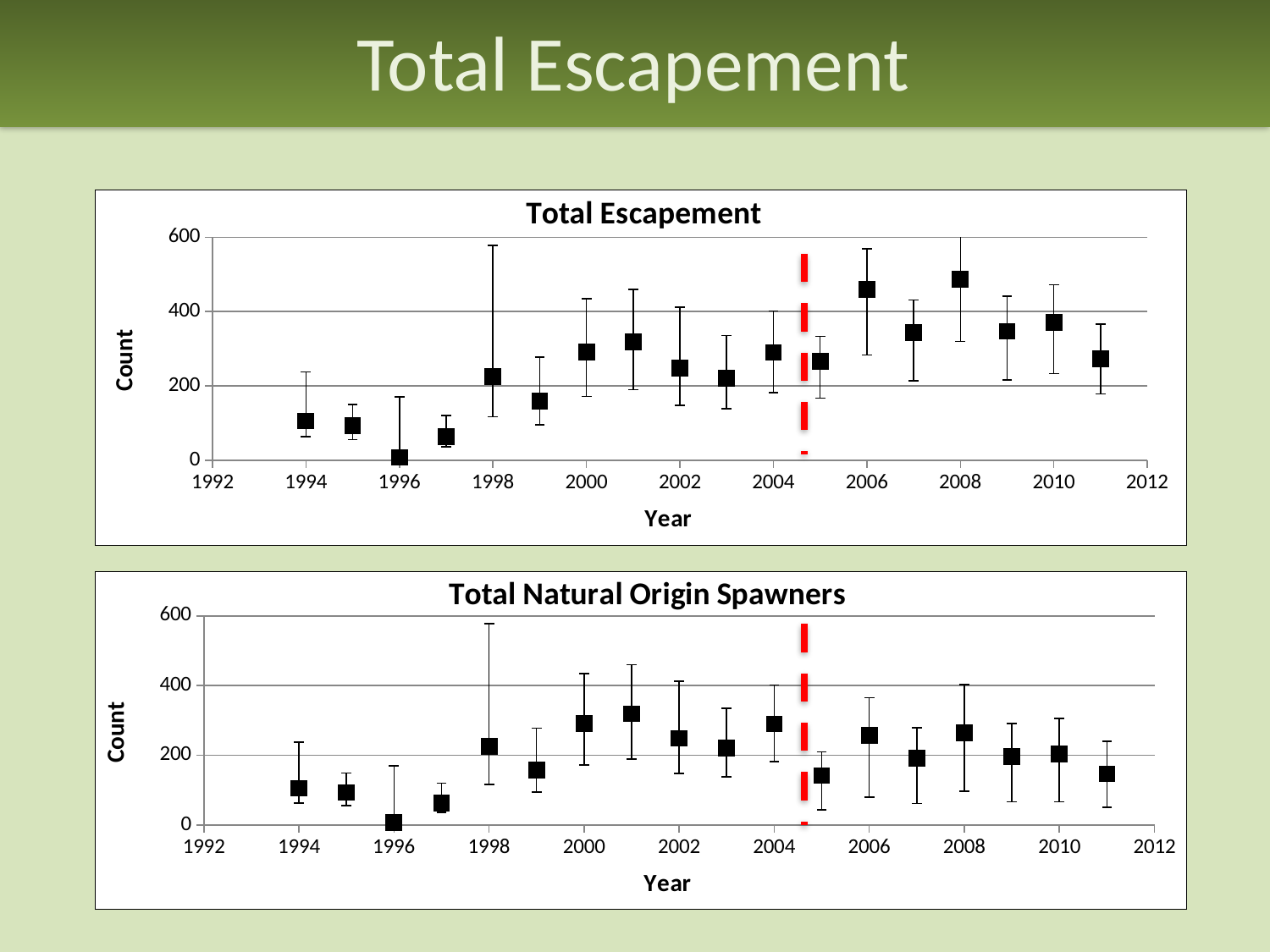
In the Total Escapement chart, which year has the lowest count? 1996 In the Total Escapement chart, what is the label on the vertical axis? Count In the Total Natural Origin Spawners chart, is the value for 2005 greater or less than 200? less In the Total Natural Origin Spawners chart, which year has the lowest count? 1996 What kind of chart is the Total Natural Origin Spawners chart? scatter chart In the Total Escapement chart, is the value for 2006 greater or less than 400? greater In the Total Escapement chart, which is larger, the value for 2005 or the value for 2006? 2006 In the Total Escapement chart, which year has the highest count? 2008 In the Total Natural Origin Spawners chart, which year has the highest count? 2001 In the Total Escapement chart, how many data points are plotted? 18 In the Total Natural Origin Spawners chart, do the values rise or fall from 1996 to 2001? rise In the Total Escapement chart, is the value for 1994 greater or less than 200? less